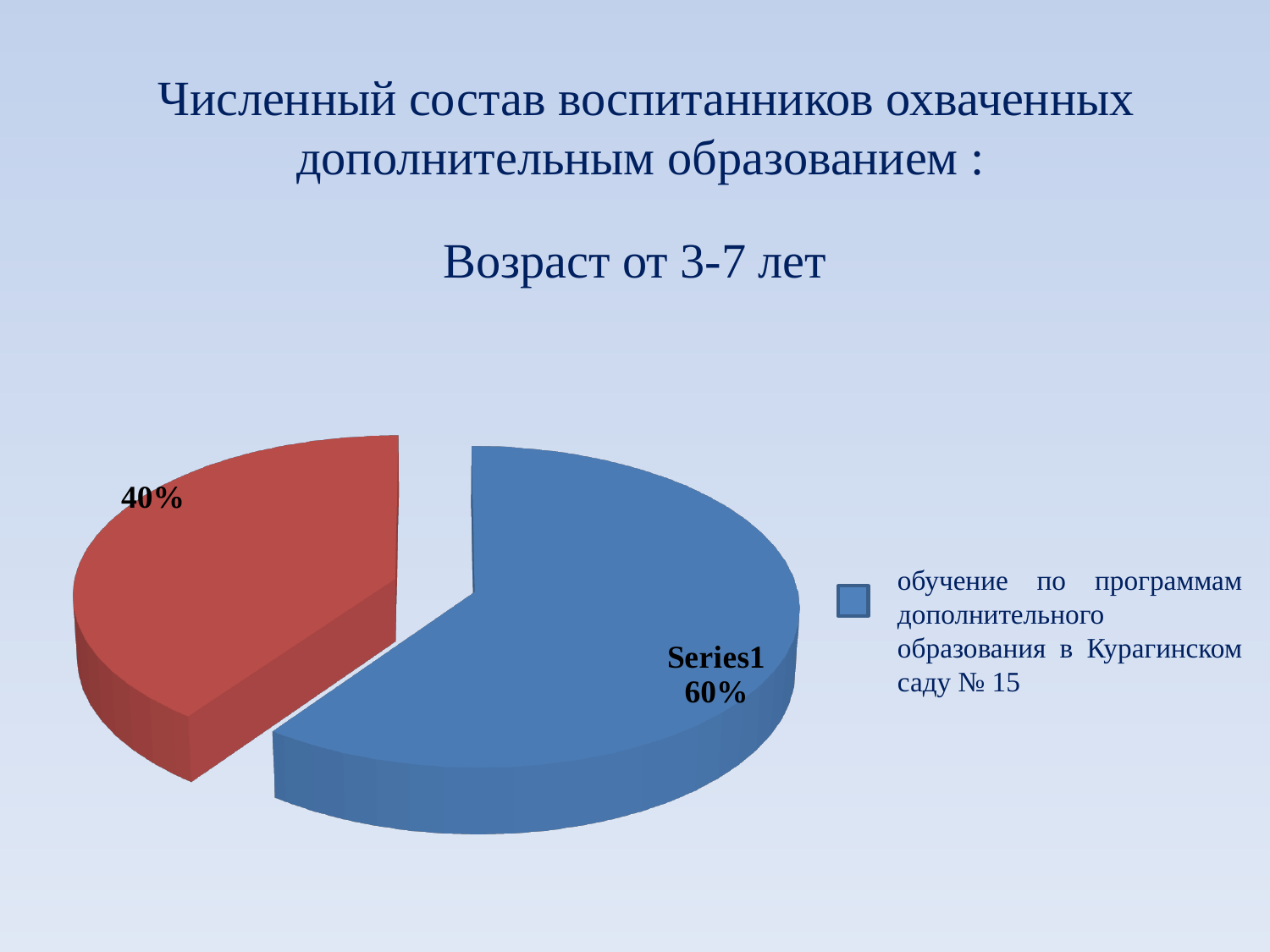
What share of the pie does the blue slice (Series1) represent? 60% Which is larger, the blue slice or the red slice? the blue slice How many slices does the pie chart have? 2 What is the difference in percentage points between the blue slice and the red slice? 20 percentage points What share of the pie does the red slice represent? 40% Is the share of the blue slice greater or less than 50%? greater What legend entry is shown next to the blue square? обучение по программам дополнительного образования в Курагинском саду № 15 Which slice of the pie is the largest? the blue slice (Series1, 60%) What kind of chart is shown on the slide? pie chart What is the age range stated in the chart's title? от 3-7 лет Which slice of the pie is the smallest? the red slice (40%)